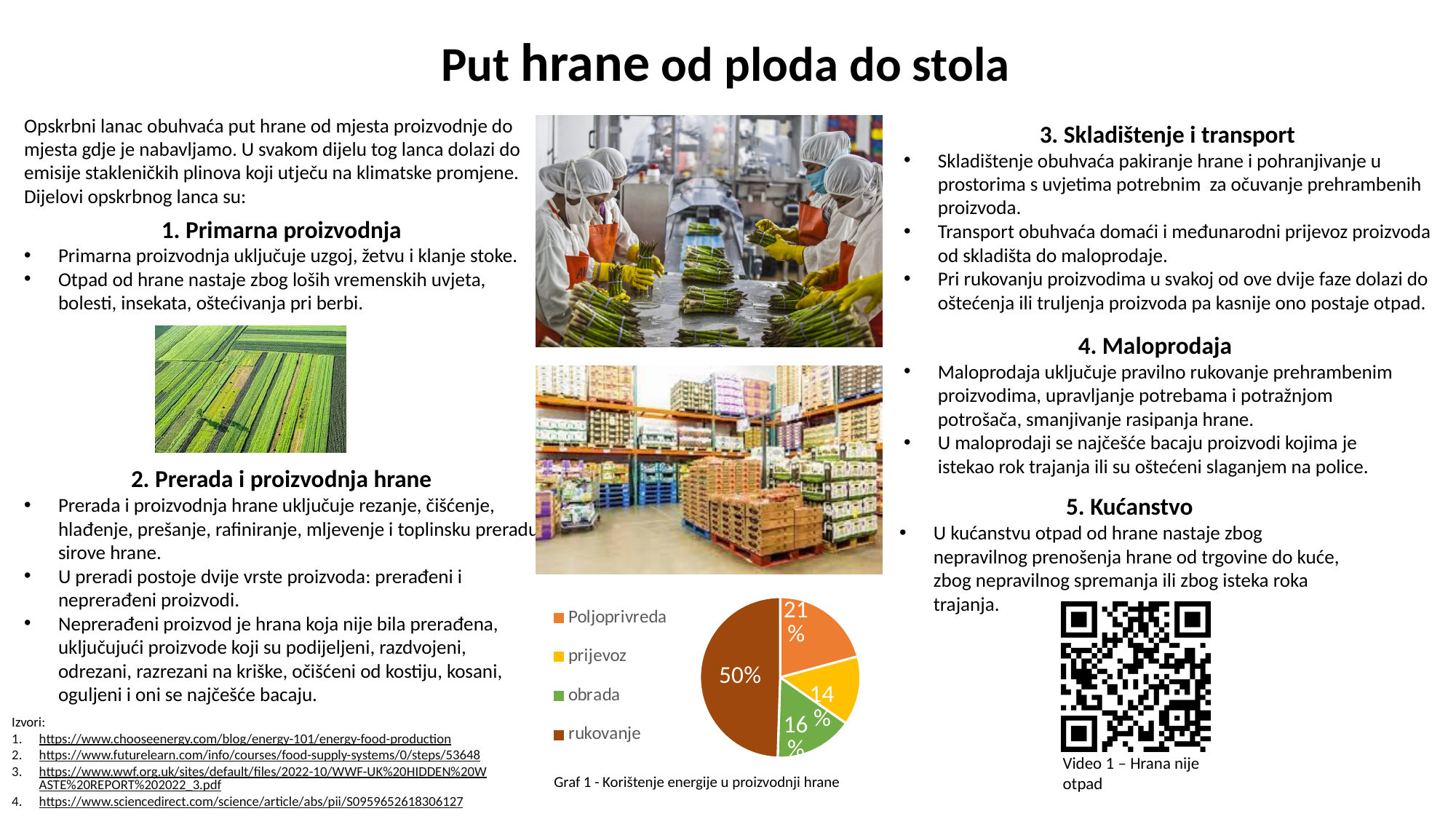
What is the difference between the values for rukovanje and Poljoprivreda? 29% What is the value for obrada in the pie chart? 16% What kind of chart is shown on the slide? pie chart What is the value for prijevoz in the pie chart? 14% What is the caption of the chart? Graf 1 - Korištenje energije u proizvodnji hrane Which category has the largest slice in the pie chart? rukovanje What share of the pie chart does rukovanje take? 50% Which category has the smallest slice in the pie chart? prijevoz What colour is the slice for rukovanje? brown Which is larger, the value for obrada or the value for prijevoz? obrada What is the value for Poljoprivreda in the pie chart? 21% How many categories does the pie chart show? 4